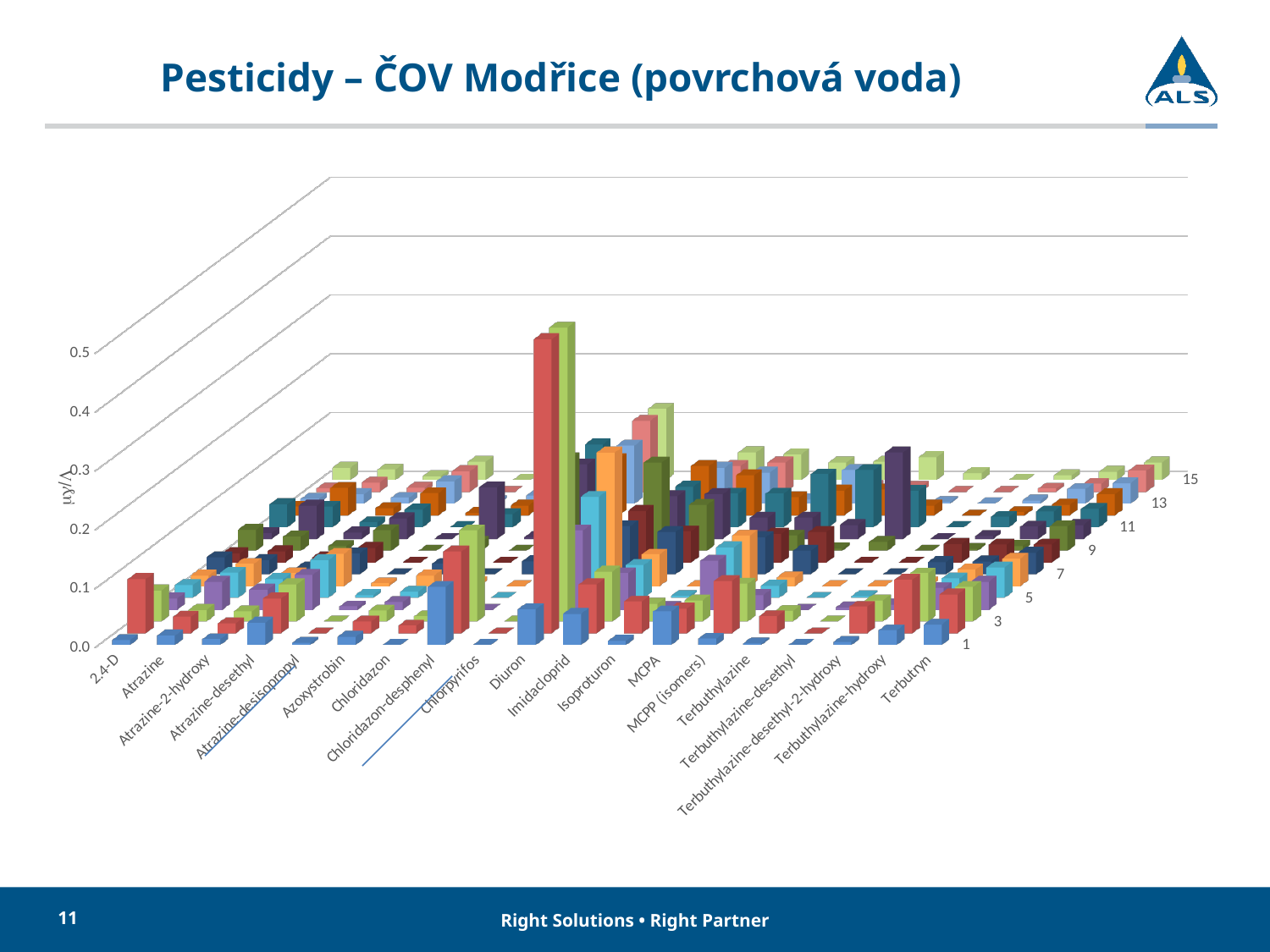
What kind of chart is shown on the slide? bar chart Which is the first pesticide category on the horizontal axis? 2.4-D What is the lowest value labelled on the vertical axis? 0.0 What is the title of the chart? Pesticidy – ČOV Modřice (povrchová voda) What is the highest number labelled on the depth axis of the chart? 15 Which pesticide has the tallest bar in the chart? Diuron What unit is shown on the vertical axis of the chart? µg/l What is the highest value labelled on the vertical axis? 0.5 How many pesticide categories are listed along the horizontal axis? 19 Which is the last pesticide category on the horizontal axis? Terbutryn